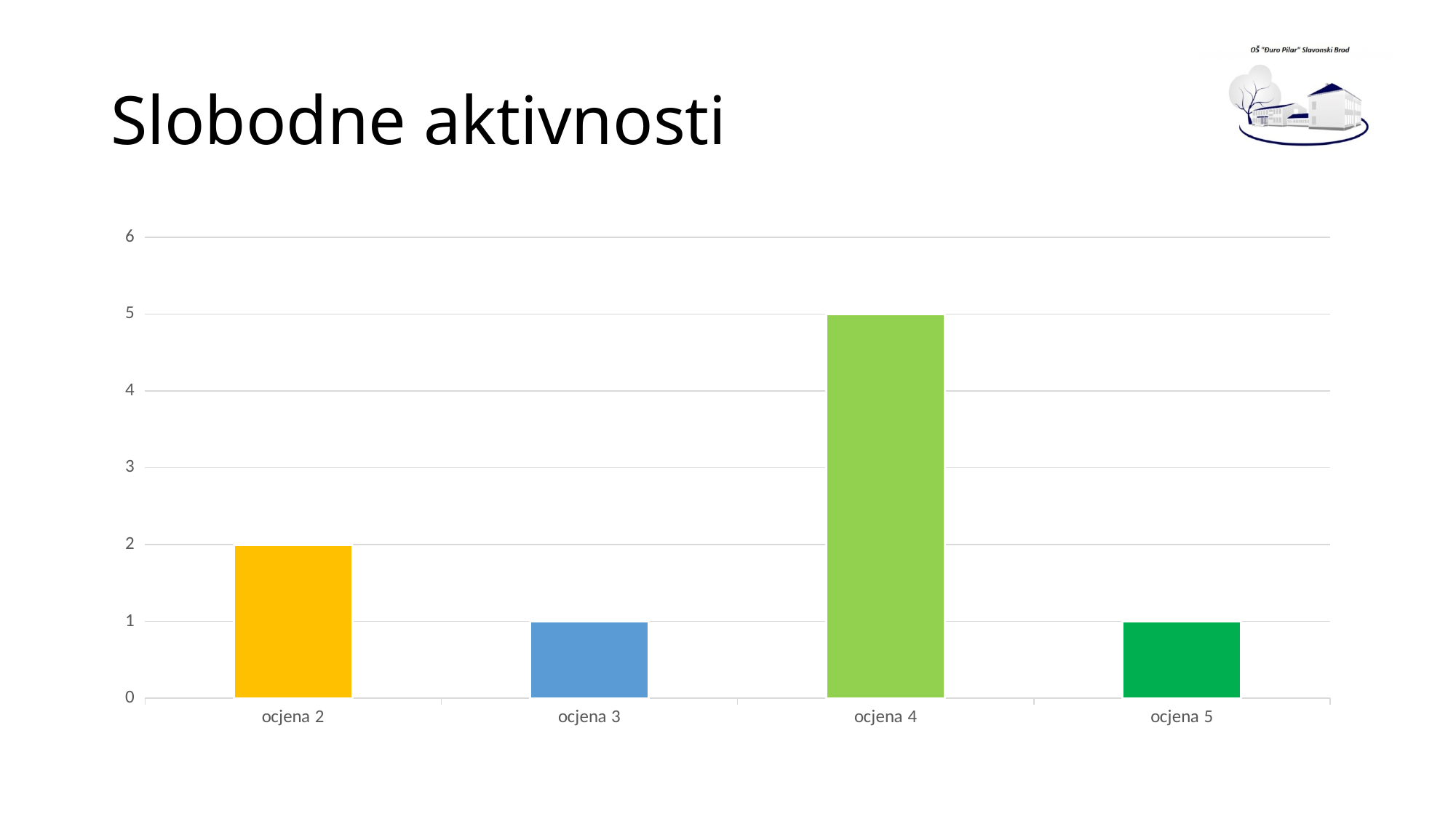
What is the value for ocjena 3? 1 What colour is the bar for ocjena 2? yellow What is the difference between the values for ocjena 4 and ocjena 2? 3 What kind of chart is shown on the slide? bar chart Is the value for ocjena 4 greater or less than 3? greater Which category has the highest value? ocjena 4 What is the value for ocjena 4? 5 What is the total of all four bar values? 9 Which is larger, the value for ocjena 2 or the value for ocjena 5? ocjena 2 How many categories are shown on the x axis? 4 What is the title of the slide containing the chart? Slobodne aktivnosti What is the value for ocjena 2? 2